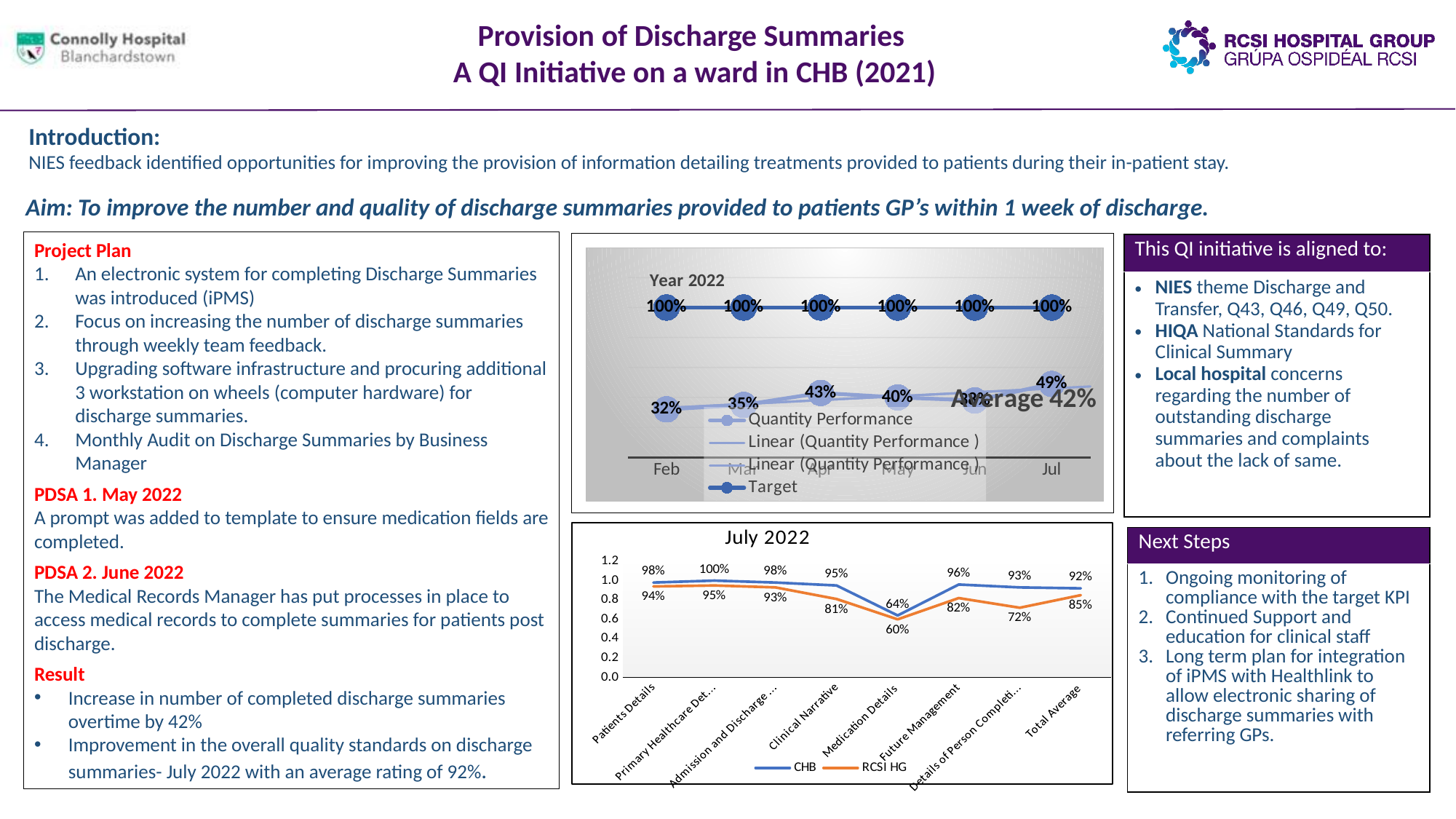
In the 'July 2022' chart, what is the difference between the CHB and RCSI HG values for Total Average? 7% In the 'Year 2022' chart, which month has the highest Quantity Performance value? Jul In the 'Year 2022' chart, what is the Target value shown for each month? 100% In the 'Year 2022' chart, what is the Quantity Performance value for Feb? 32% In the 'July 2022' chart, what is the RCSI HG value for Clinical Narrative? 81% In the 'Year 2022' chart, what is the difference between the Quantity Performance values for Apr and Feb? 11% What kind of chart is the 'July 2022' chart? Line chart In the 'July 2022' chart, which category has the lowest RCSI HG value? Medication Details In the 'July 2022' chart, what is the CHB value for Medication Details? 64% In the 'Year 2022' chart, which month has the lowest Quantity Performance value? Feb In the 'July 2022' chart, how many series does the legend list? 2 In the 'Year 2022' chart, what is the Quantity Performance value for Jul? 49%